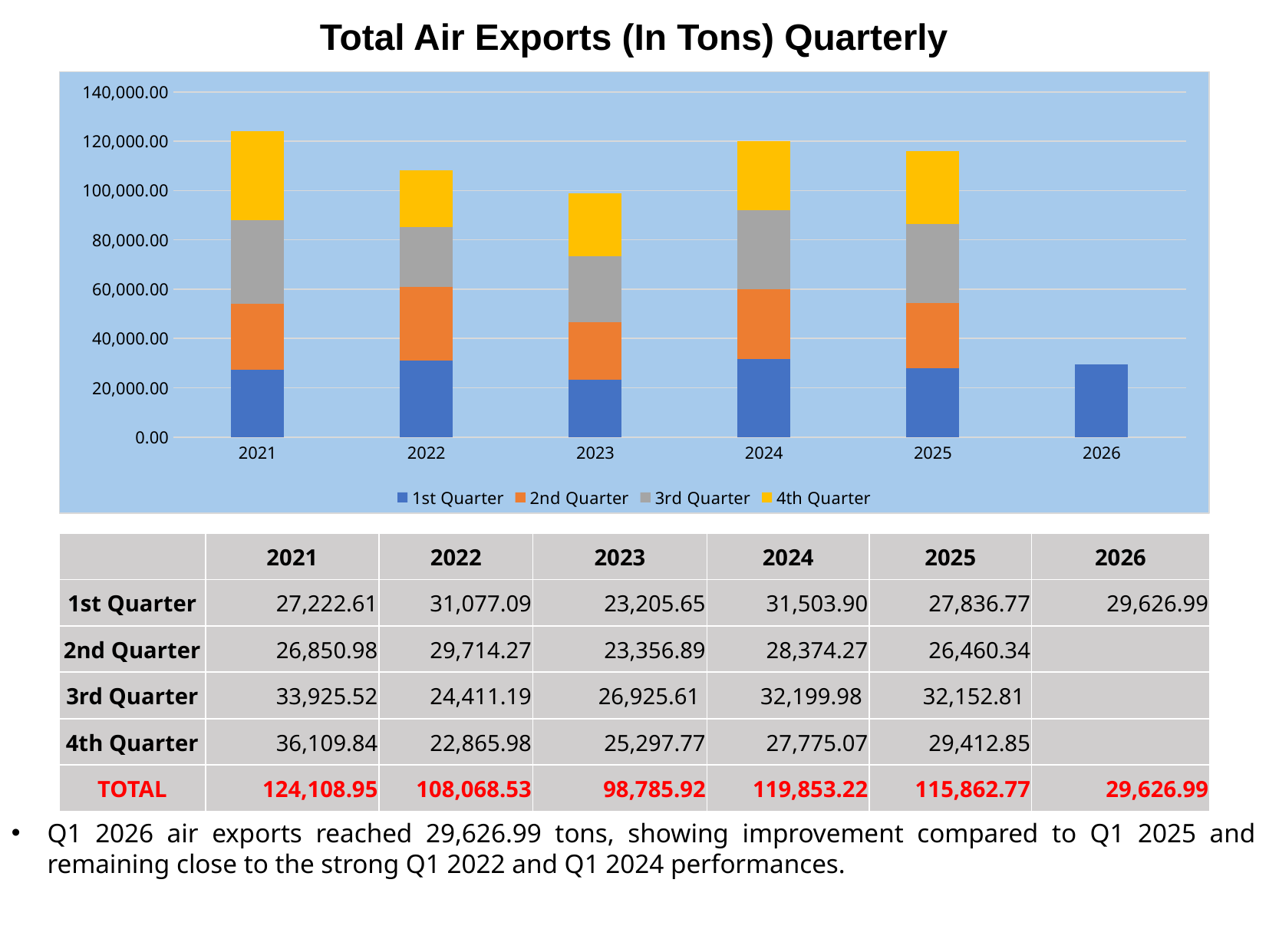
Is the total for 2023 greater or less than 100,000.00? less Which is larger, the 4th Quarter value for 2021 or for 2022? 2021 What kind of chart is shown? Stacked bar chart What is the 4th Quarter value for 2021? 36,109.84 What is the total of the stacked bar for 2025? 115,862.77 What is the 3rd Quarter value for 2024? 32,199.98 Which year has the highest total air exports? 2021 What is the 1st Quarter value for 2026? 29,626.99 How many series does the legend list? 4 How many years are shown on the x axis? 6 Which year has the lowest total air exports? 2026 What is the difference between the 2021 total and the 2023 total? 25,323.03